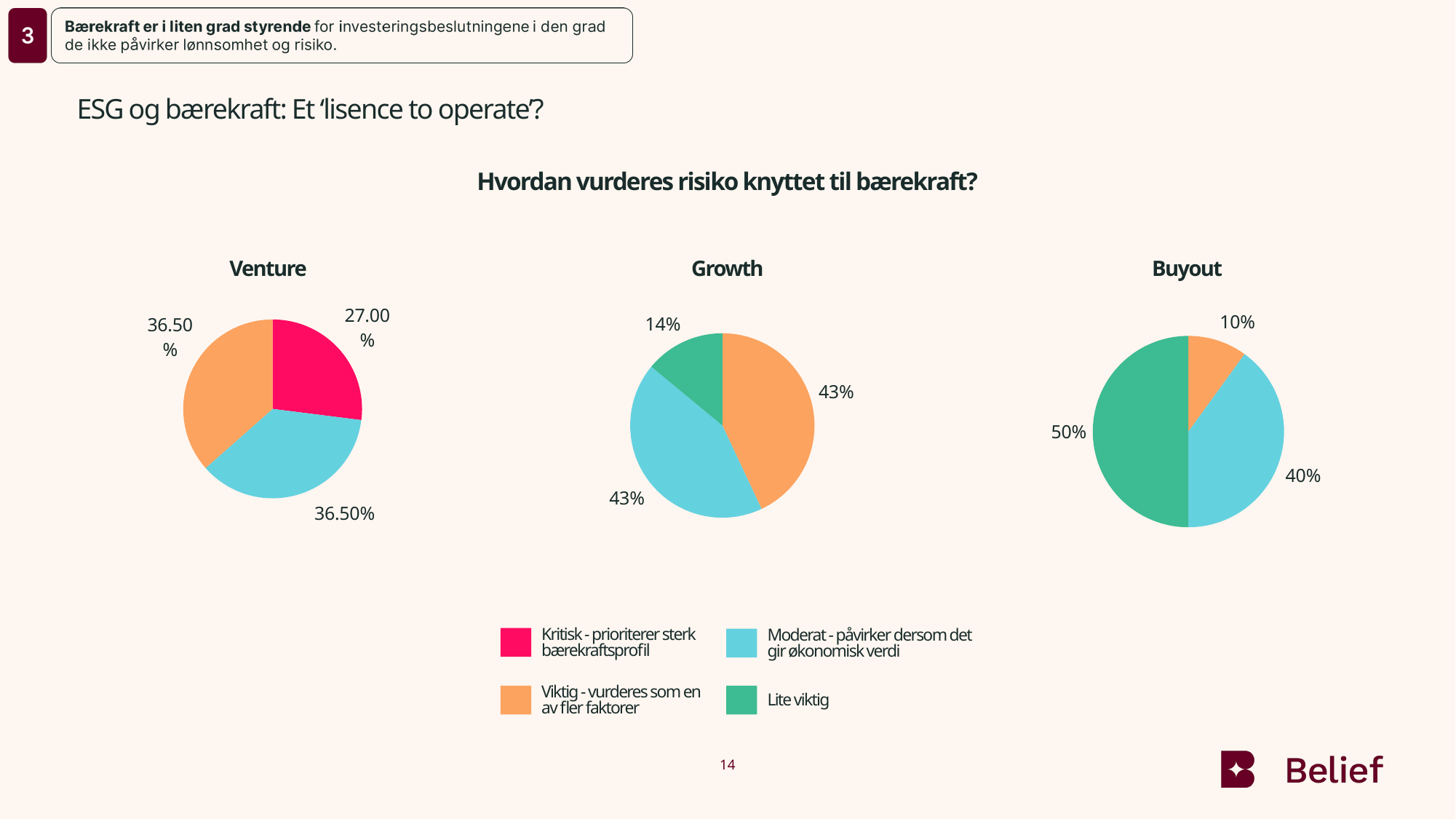
In the Buyout pie chart, what is the difference between the Lite viktig share and the Moderat share? 10% How many slices does the Venture pie chart have? 3 What kind of charts are shown on the slide? Pie charts In the Growth pie chart, which category has the smallest slice? Lite viktig In the Growth pie chart, what share is labelled for the Lite viktig slice? 14% In the Buyout pie chart, what share is labelled for the Lite viktig slice? 50% In the Venture pie chart, what share is labelled for the Kritisk slice? 27.00% In the Buyout pie chart, which category has the largest slice? Lite viktig How many categories does the legend list? 4 In the Venture pie chart, what share is labelled for the Moderat slice? 36.50% In the Buyout pie chart, what share is labelled for the Viktig slice? 10% In the Growth pie chart, what share is labelled for the Viktig slice? 43%